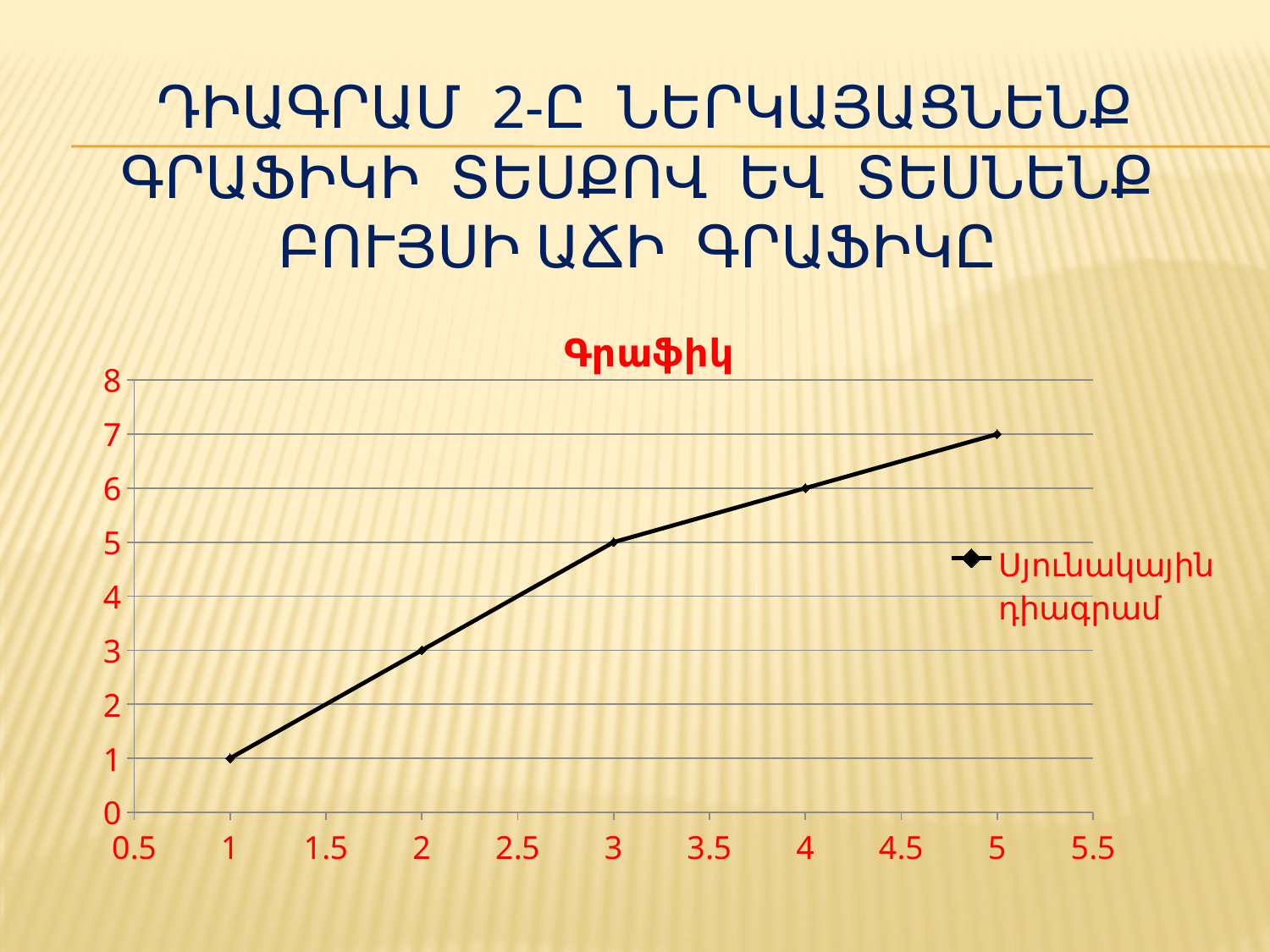
What is the y value at x = 1? 1 At which x value is the plotted y value highest? 5 What is the name of the series in the legend? Սյունակային դիագրամ How many series does the legend list? 1 What is the y value at x = 5? 7 What is the y value at x = 3? 5 At which x value is the plotted y value lowest? 1 What is the difference between the y values at x = 4 and x = 2? 3 What is the title of the chart? Գրաֆիկ Do the values rise or fall as x increases from 1 to 5? rise What kind of chart is shown on the slide? line chart How many data points are plotted on the line? 5